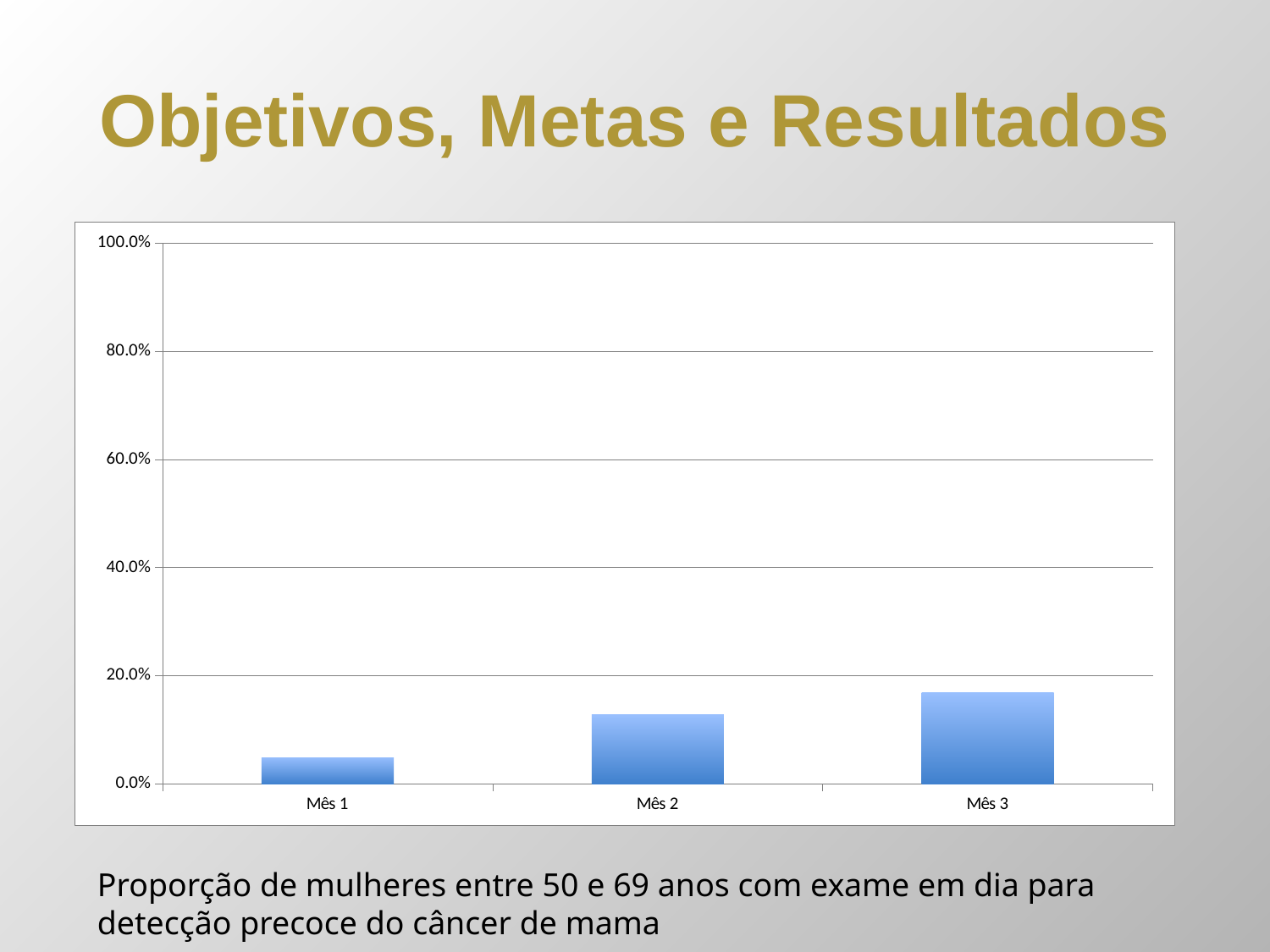
Which is larger, the value for Mês 1 or the value for Mês 2? Mês 2 Is the value for Mês 1 greater or less than 20.0%? less Is the value for Mês 2 greater or less than 40.0%? less What is the highest value shown on the vertical axis of the chart? 100.0% Do the values rise or fall from Mês 1 to Mês 3? rise What is the label of the first category on the x axis? Mês 1 What kind of chart is shown on the slide? bar chart Which is larger, the value for Mês 2 or the value for Mês 3? Mês 3 Is the value for Mês 3 greater or less than 20.0%? less How many categories are plotted on the x axis of the chart? 3 Which month has the lowest bar in the chart? Mês 1 Which month has the highest bar in the chart? Mês 3